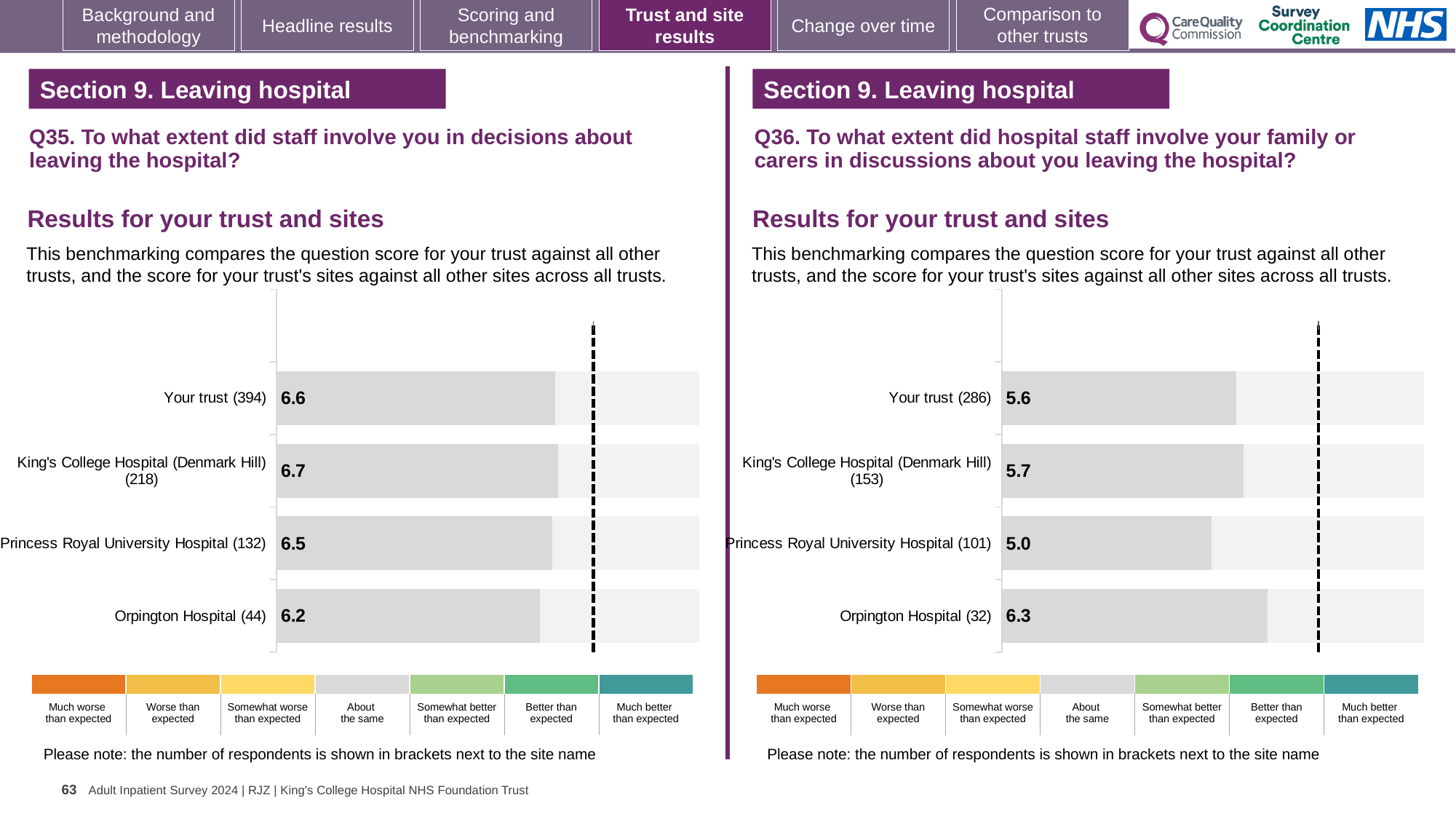
On the Q36 chart (right), how many bars are plotted? 4 On the Q36 chart (right), what is the score for Princess Royal University Hospital (101)? 5.0 On the Q35 chart (left), what is the difference between the scores for King's College Hospital (Denmark Hill) and Orpington Hospital? 0.5 On the Q35 chart (left), which site has the highest score? King's College Hospital (Denmark Hill) On the Q35 chart (left), which site has the lowest score? Orpington Hospital What type of chart is used on the Q35 chart (left)? Bar chart On the Q36 chart (right), which site has the lowest score? Princess Royal University Hospital On the Q36 chart (right), what is the score for Your trust (286)? 5.6 On the Q36 chart (right), what is the difference between the scores for Orpington Hospital and Princess Royal University Hospital? 1.3 On the Q35 chart (left), what is the score for Orpington Hospital (44)? 6.2 On the Q35 chart (left), what is the score for Your trust (394)? 6.6 On the Q36 chart (right), which site has the highest score? Orpington Hospital